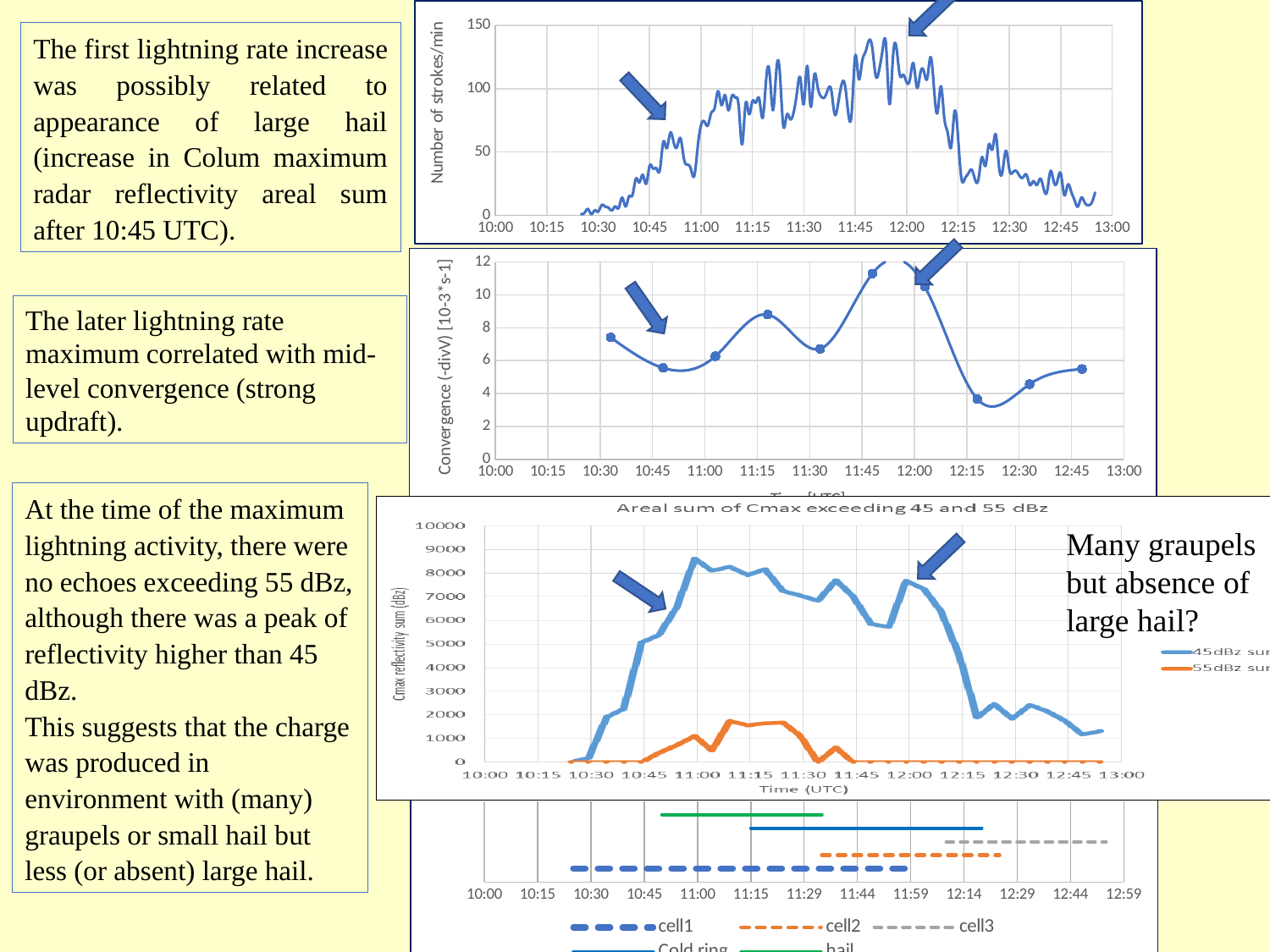
In the middle chart (Convergence), does the value rise or fall between 12:03 and 12:18? fall In the top chart (Number of strokes/min), is the peak value reached around 11:50 greater or less than 100? greater What is the title of the chart with the blue and orange lines? Areal sum of Cmax exceeding 45 and 55 dBz In the middle chart (Convergence), is the lowest point (around 12:18) greater or less than 4? less In the chart 'Areal sum of Cmax exceeding 45 and 55 dBz', which series has the larger value at 11:15, 45dBz sum or 55dBz sum? 45dBz sum In the middle chart (Convergence), how many data points are plotted? 10 In the chart 'Areal sum of Cmax exceeding 45 and 55 dBz', is the highest value of the 55dBz sum series greater or less than 2000? less What kind of chart is the top chart showing the number of strokes per minute? line chart In the chart 'Areal sum of Cmax exceeding 45 and 55 dBz', how many series does the legend list? 2